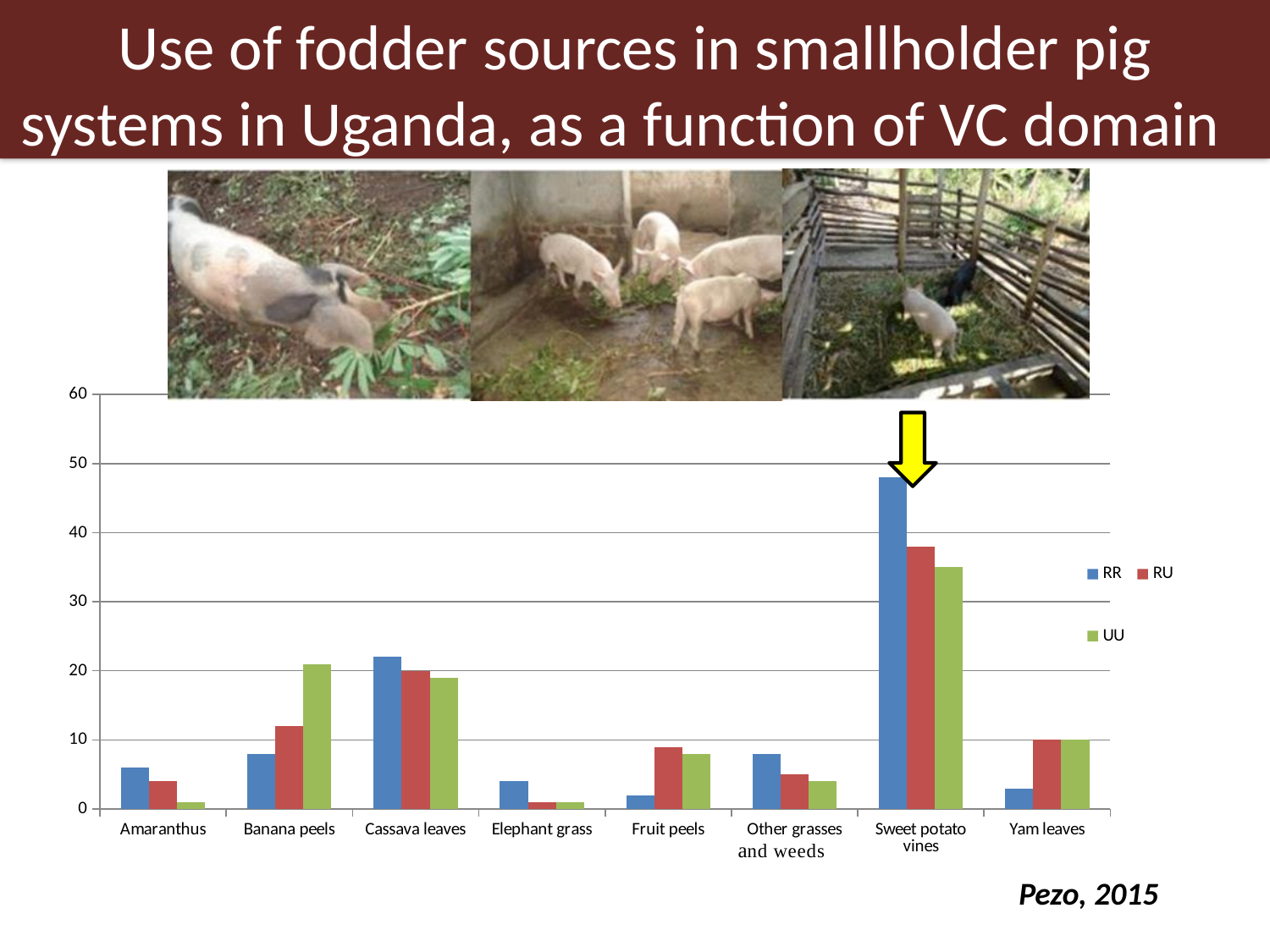
What are the names of the three series in the legend? RR, RU, UU What kind of chart is shown on the slide? bar chart For Sweet potato vines, which series has the larger value, RR or RU? RR Is the UU value for Sweet potato vines greater or less than 40? less Is the RR value for Sweet potato vines greater or less than 40? greater For Banana peels, which series has the larger value, RR or UU? UU Which fodder source has the highest UU value? Sweet potato vines Is the UU value for Banana peels greater or less than 20? greater Which fodder source has the highest RR value? Sweet potato vines How many fodder source categories are shown on the x axis? 8 How many series does the legend list? 3